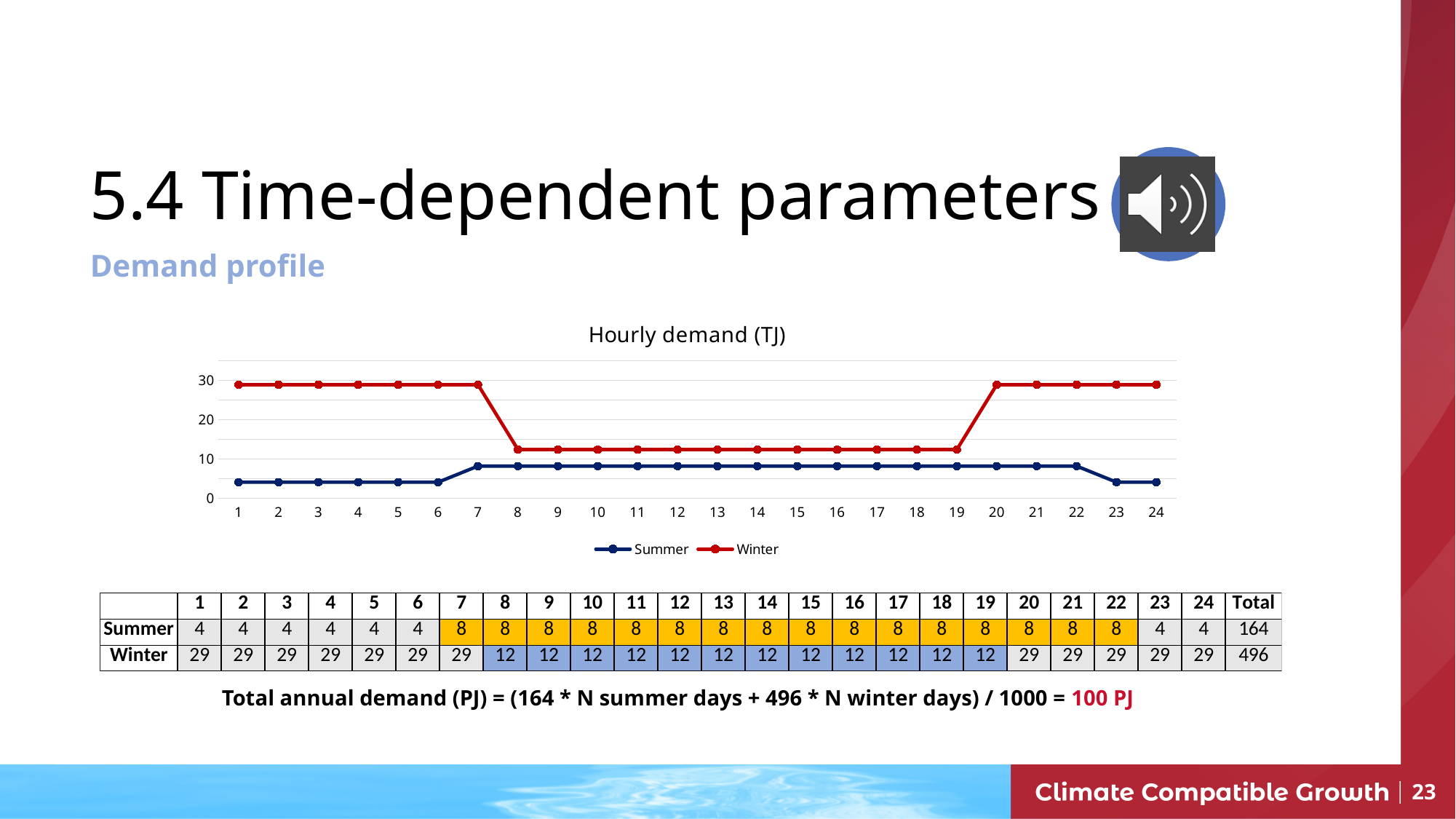
What is the title of the chart? Hourly demand (TJ) What kind of chart is shown on the slide? line chart How many hourly points are plotted along the x axis of the chart? 24 Does the Winter series rise or fall between hour 7 and hour 8? fall Is the Winter value at hour 15 greater or less than 20? less Which colour is used for the Winter series in the chart? red What is the Winter demand value at hour 3? 29 What is the Summer demand value at hour 10? 8 Which series has the higher value at hour 12, Summer or Winter? Winter What is the Winter demand value at hour 12? 12 How many series does the legend of the chart list? 2 What is the difference between the Winter and Summer values at hour 1? 25